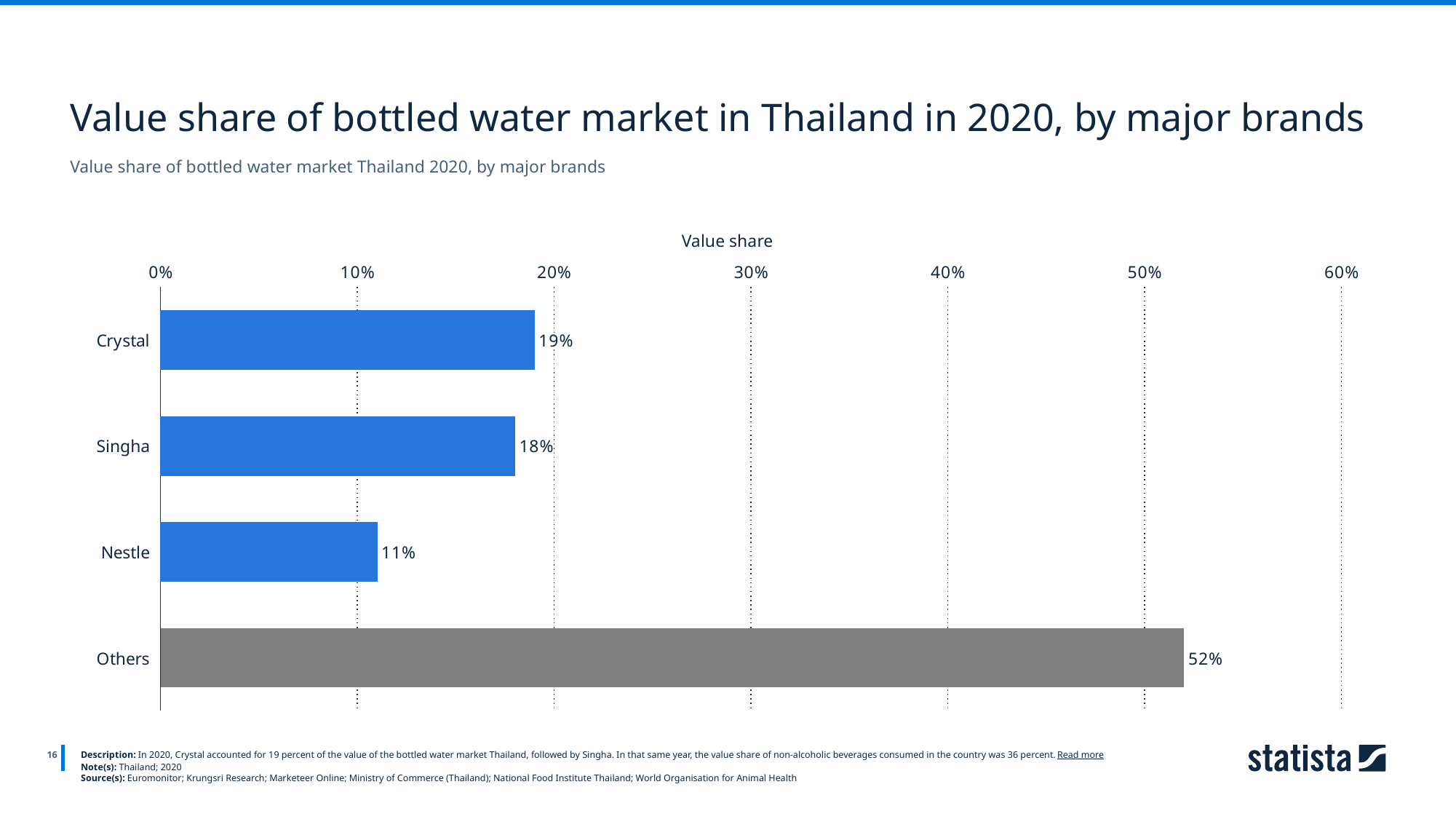
What is the value share for Nestle? 11% What is the value share for Others? 52% Which has a larger value share, Crystal or Nestle? Crystal Which category has the lowest value share? Nestle What is the value share for Singha? 18% Is the value share for Others greater or less than 50%? greater What is the difference in value share between Others and Singha? 34% What is the value share for Crystal? 19% What is the difference in value share between Crystal and Nestle? 8% What kind of chart is shown on the slide? Bar chart Which category has the highest value share? Others How many categories are shown in the chart? 4